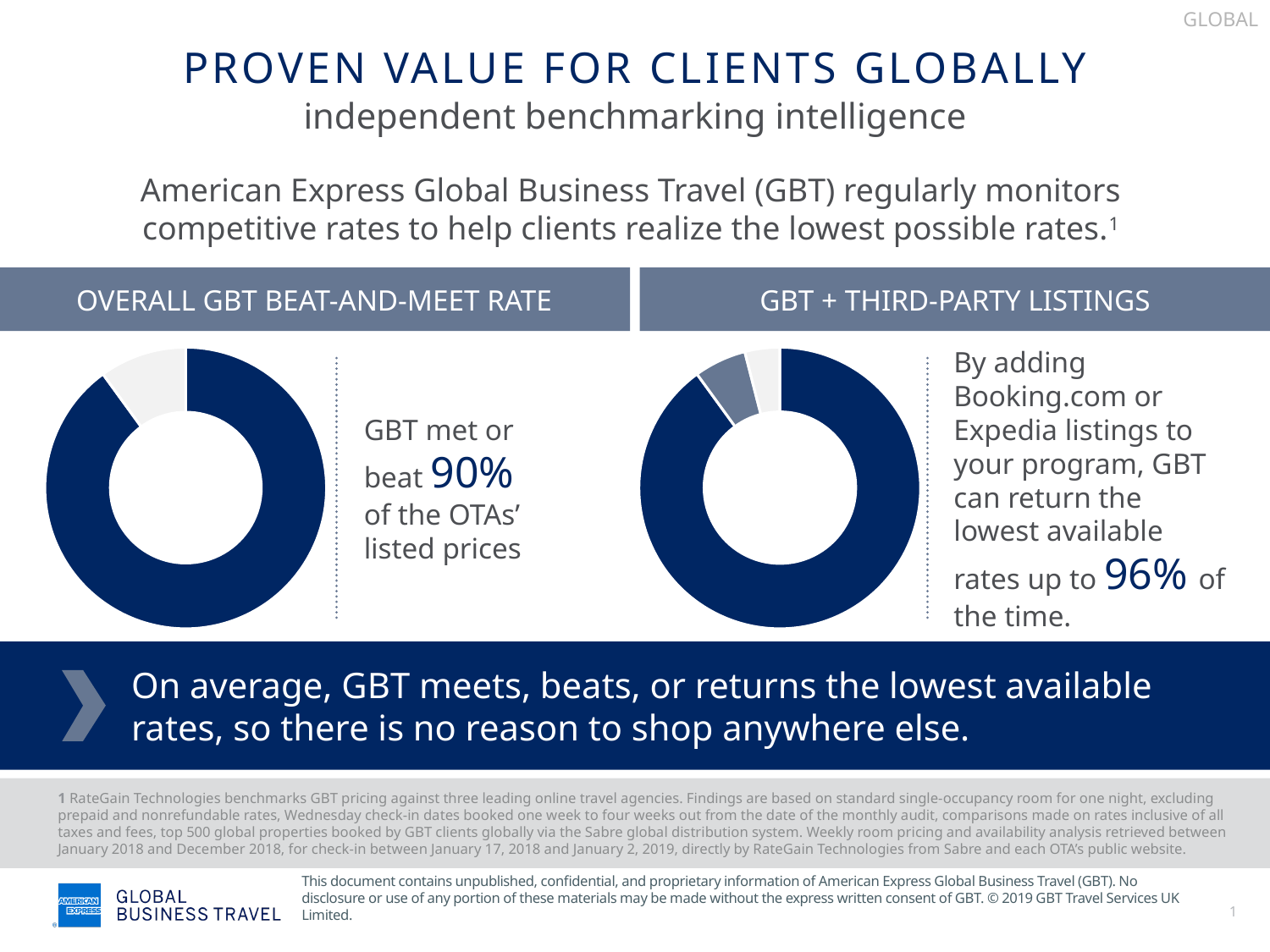
What kind of chart is shown under the heading GBT + THIRD-PARTY LISTINGS? Donut (pie) chart In the GBT + THIRD-PARTY LISTINGS donut chart, which slice is the largest? The dark blue slice What kind of chart is shown under the heading OVERALL GBT BEAT-AND-MEET RATE? Donut (pie) chart In the OVERALL GBT BEAT-AND-MEET RATE donut chart, which slice is larger, the dark blue one or the light grey one? The dark blue one Which of the two donut charts has more slices? GBT + THIRD-PARTY LISTINGS According to the OVERALL GBT BEAT-AND-MEET RATE chart, what share of the OTAs' listed prices did GBT meet or beat? 90% According to the GBT + THIRD-PARTY LISTINGS chart, up to what share of the time can GBT return the lowest available rates when Booking.com or Expedia listings are added? 96% How many slices does the OVERALL GBT BEAT-AND-MEET RATE donut chart have? 2 What is the heading above the right donut chart? GBT + THIRD-PARTY LISTINGS In the GBT + THIRD-PARTY LISTINGS donut chart, is the dark blue slice greater or less than 50% of the donut? greater What is the heading above the left donut chart? OVERALL GBT BEAT-AND-MEET RATE How many slices does the GBT + THIRD-PARTY LISTINGS donut chart have? 3